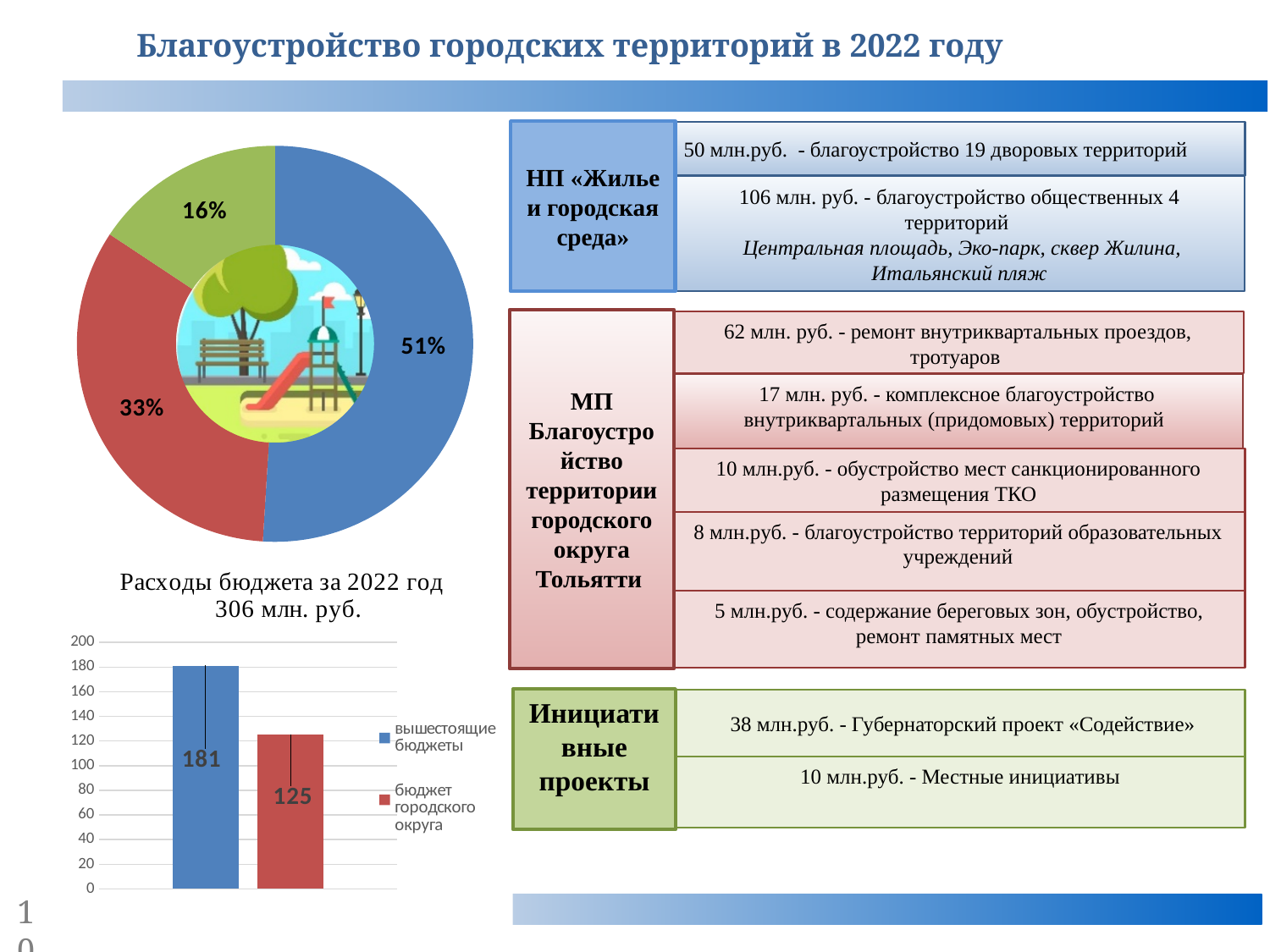
What kind of chart is the chart in the lower left of the slide? bar chart In the bar chart at the bottom left, what is the difference between 'вышестоящие бюджеты' and 'бюджет городского округа'? 56 In the bar chart at the bottom left, how many series does the legend list? 2 In the pie chart on the left, what is the largest percentage shown? 51% In the pie chart on the left, what is the smallest percentage shown? 16% What kind of chart is the chart in the upper left of the slide? doughnut chart In the pie chart on the left, how many slices are there? 3 In the pie chart on the left, what is the difference in percentage points between the largest slice and the second-largest slice? 18 In the bar chart at the bottom left, what is the value for 'вышестоящие бюджеты'? 181 In the bar chart at the bottom left, is the value for 'бюджет городского округа' greater or less than 140? less In the bar chart at the bottom left, which series has the higher value? вышестоящие бюджеты In the bar chart at the bottom left, what is the value for 'бюджет городского округа'? 125